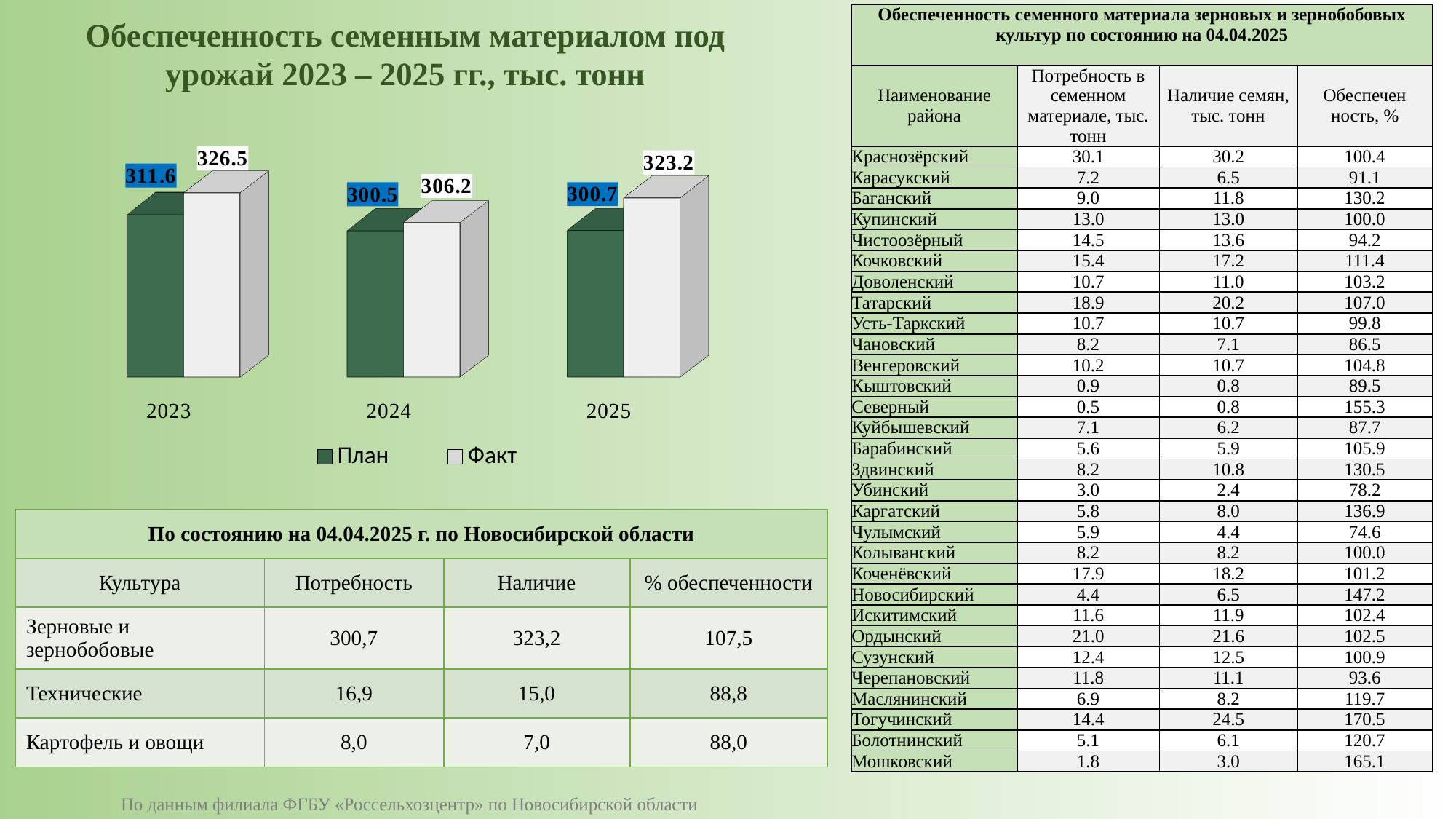
How many series does the chart legend list? 2 What kind of chart is shown on the slide? Bar chart Which is larger for 2024: the План value or the Факт value? Факт How many years are shown on the x axis of the chart? 3 What is the difference between the Факт and План values for 2025? 22.5 Which year has the highest Факт value in the chart? 2023 What is the Факт value for 2025 in the chart? 323.2 What is the План value for 2023 in the chart? 311.6 What is the difference between the Факт values for 2023 and 2024? 20.3 Which year has the lowest План value in the chart? 2024 Which series in the chart is shown in dark green? План What is the Факт value for 2024 in the chart? 306.2